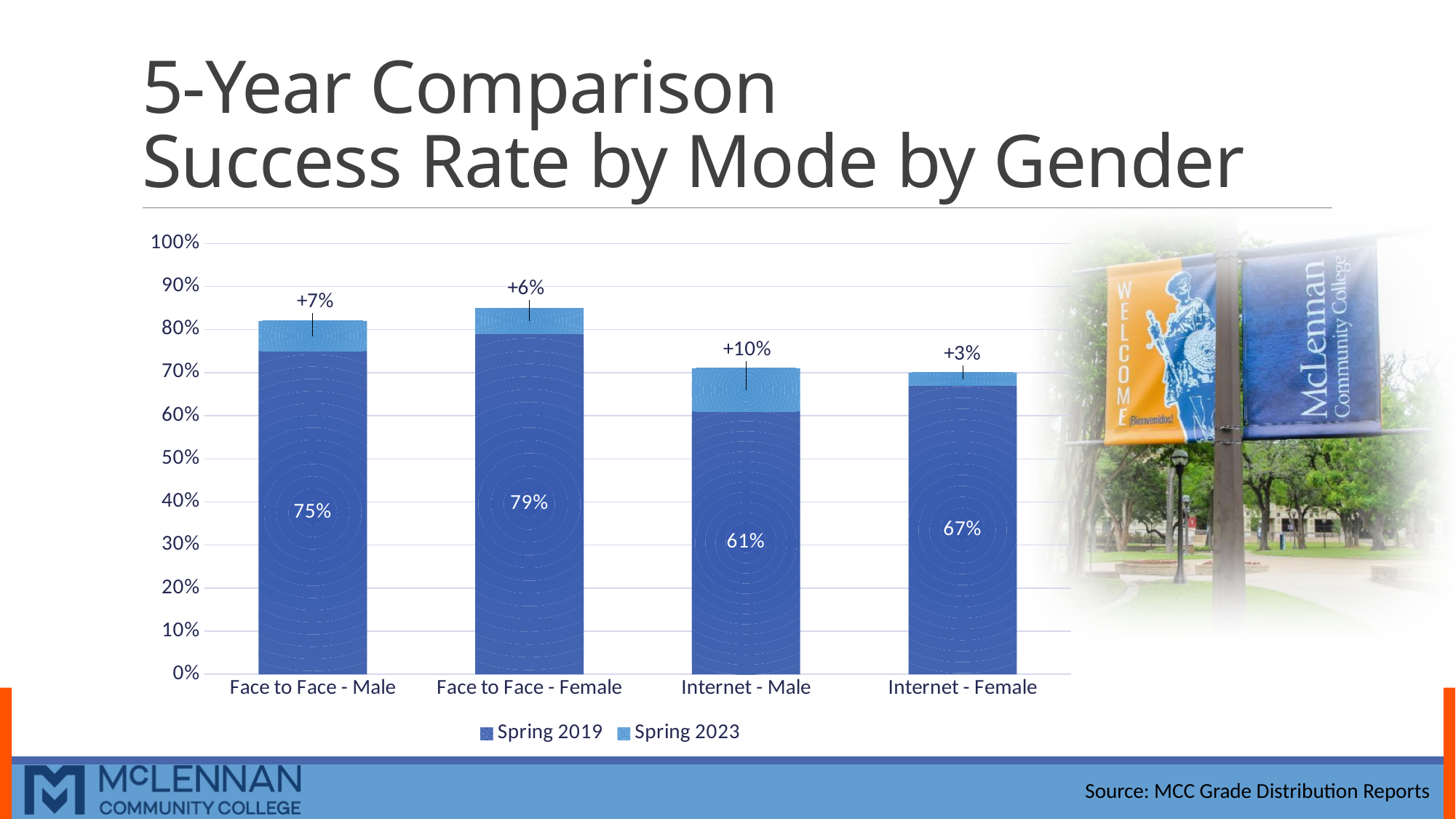
What kind of chart is shown on the slide? Stacked bar chart How many series does the legend list? 2 What is the Spring 2019 success rate for Face to Face - Male? 75% What is the difference between the Spring 2019 success rates for Face to Face - Female and Face to Face - Male? 4% What is the Spring 2023 increase label shown for Internet - Female? +3% What is the total height of the stacked bar for Face to Face - Male (Spring 2019 plus the Spring 2023 increase)? 82% Which is larger, the Spring 2019 success rate for Internet - Female or for Internet - Male? Internet - Female Which category has the lowest Spring 2019 success rate? Internet - Male Which category shows the largest Spring 2023 increase? Internet - Male Which category has the highest Spring 2019 success rate? Face to Face - Female How many categories are shown on the x axis? 4 What is the Spring 2019 success rate for Internet - Male? 61%